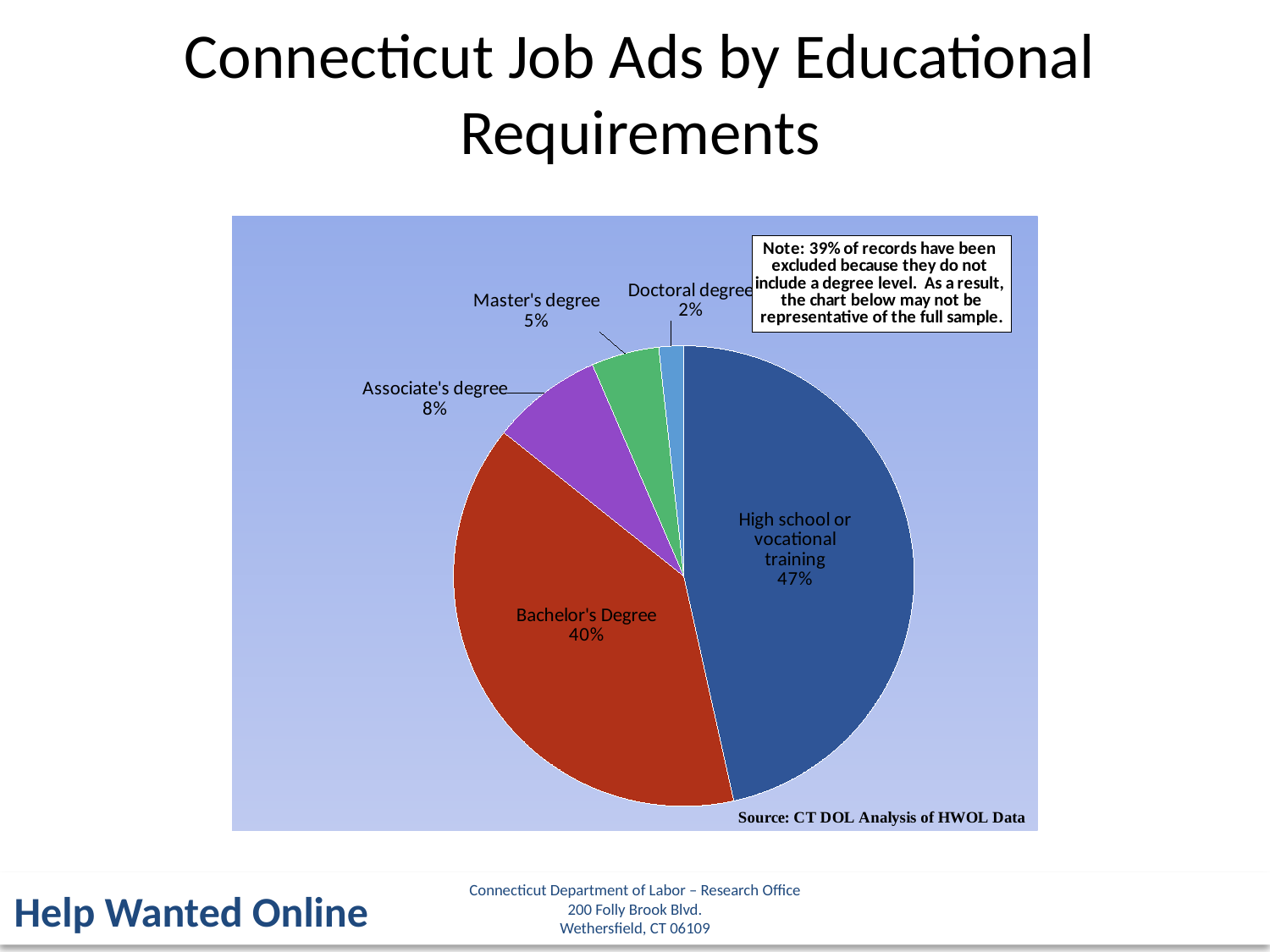
What share of job ads require an Associate's degree? 8% What kind of chart is shown on the slide? Pie chart What share of job ads require a Doctoral degree? 2% What is the difference in percentage points between the High school or vocational training share and the Bachelor's Degree share? 7 percentage points Which educational requirement has the smallest share of job ads? Doctoral degree According to the note on the chart, what percentage of records were excluded because they do not include a degree level? 39% Which is larger: the share for Associate's degree or the share for Master's degree? Associate's degree How many slices does the pie chart have? 5 What share of job ads require a Master's degree? 5% What share of Connecticut job ads require a Bachelor's Degree? 40% Which educational requirement has the largest share of job ads? High school or vocational training What share of job ads require High school or vocational training? 47%